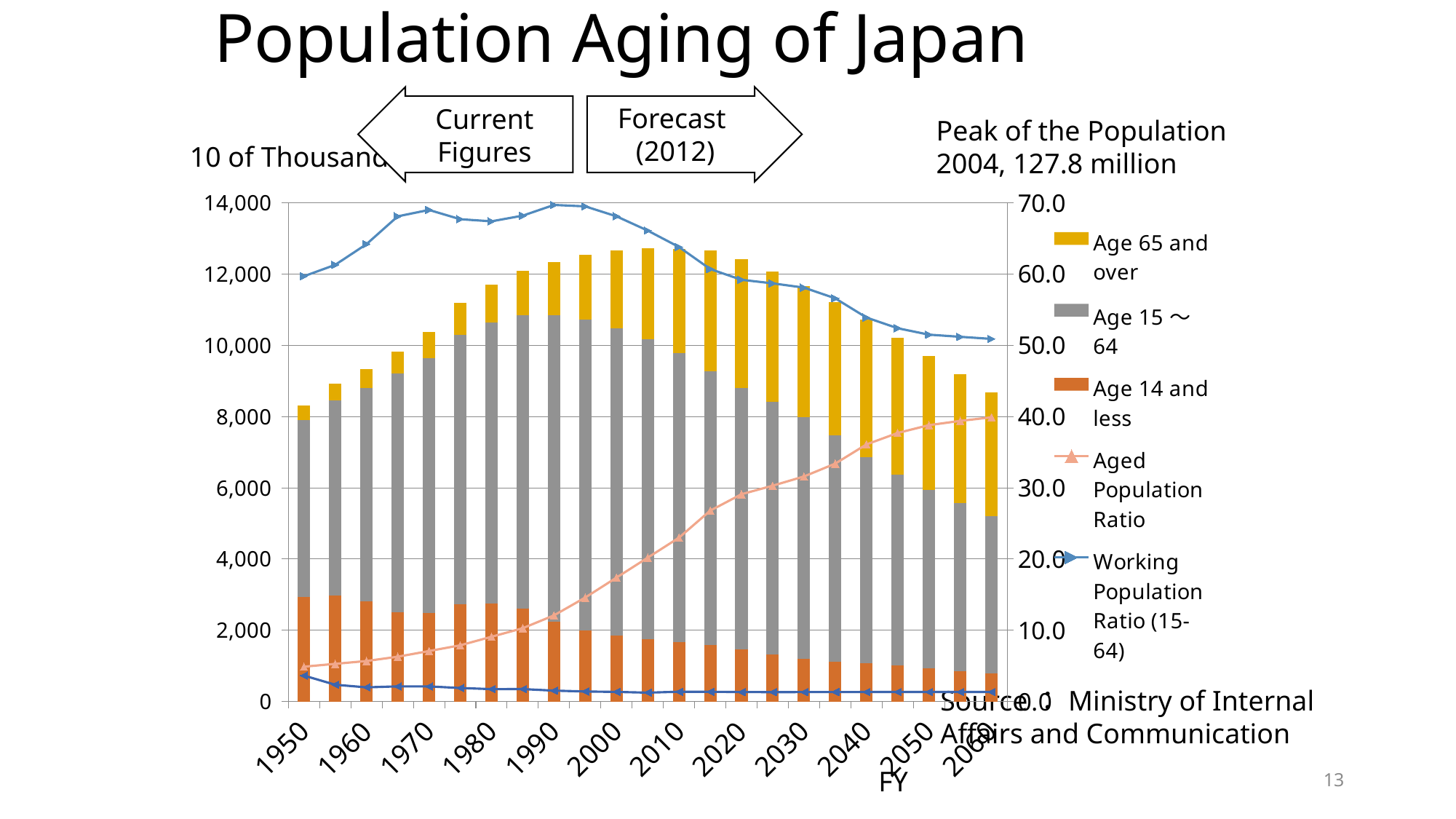
Is the Aged Population Ratio value for 2010 greater or less than 20.0? greater Which year has the larger total population bar, 1950 or 2010? 2010 How many series does the chart legend list? 5 Is the total population bar for 2010 greater or less than 12,000? greater In which year is the Aged Population Ratio highest? 2060 Is the Aged Population Ratio value for 1950 greater or less than 10.0? less Does the Aged Population Ratio line rise or fall from 1950 to 2060? rise What kind of chart is shown on the slide? A combination chart of stacked bars and lines How many stacked bars are plotted in the chart? 23 According to the text on the slide, in which year did the population peak and at what level? 2004, 127.8 million